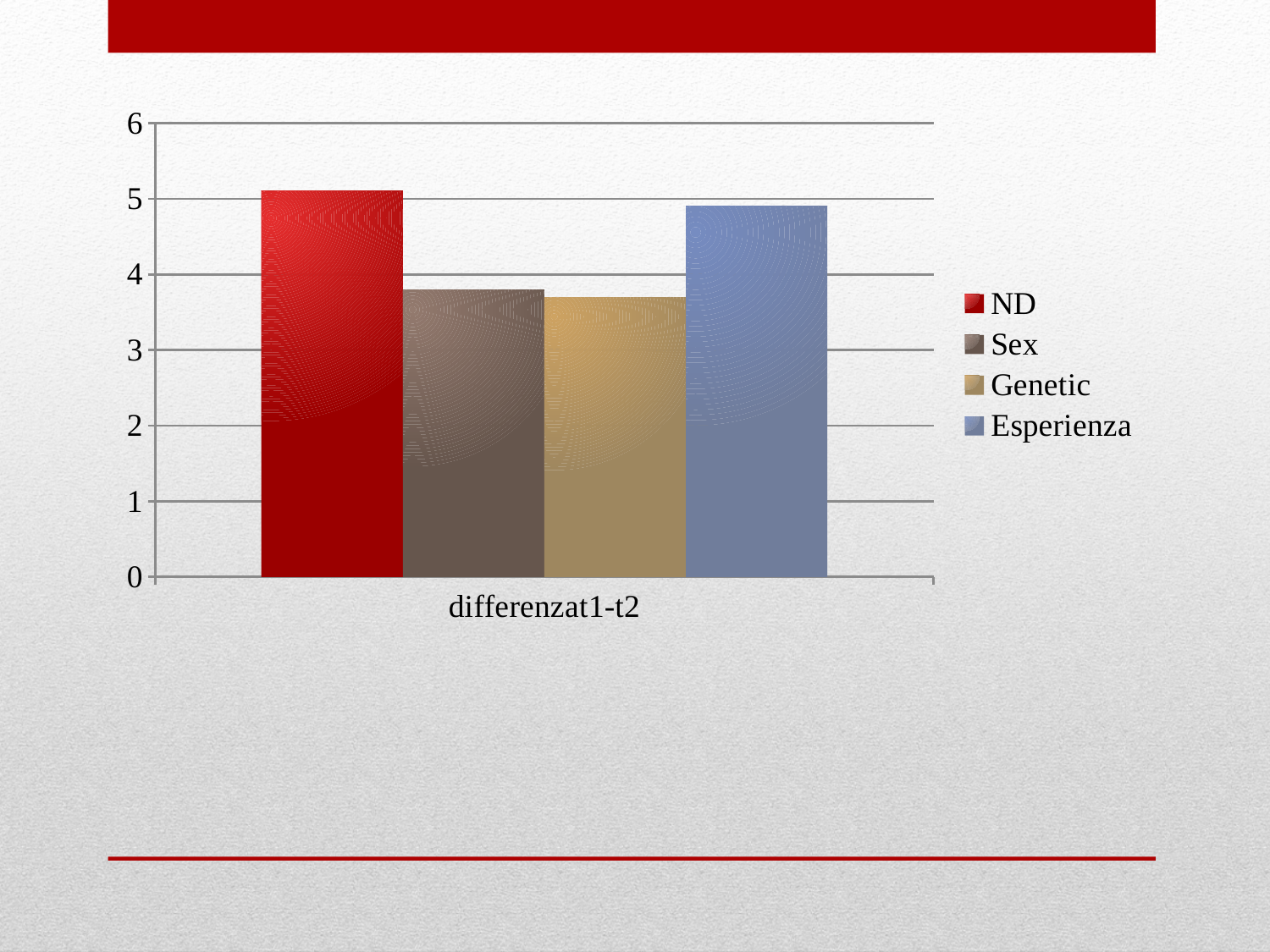
Which is larger, the value for Esperienza or the value for Genetic? Esperienza How many categories are shown on the x axis? 1 What colour is the bar for ND? red Is the value for ND greater or less than 5? greater Is the value for Esperienza greater or less than 5? less Which series has the highest bar? ND Is the value for Genetic greater or less than 3? greater What is the label shown on the x axis? differenzat1-t2 Which is larger, the value for ND or the value for Esperienza? ND What kind of chart is shown on the slide? bar chart How many series does the legend list? 4